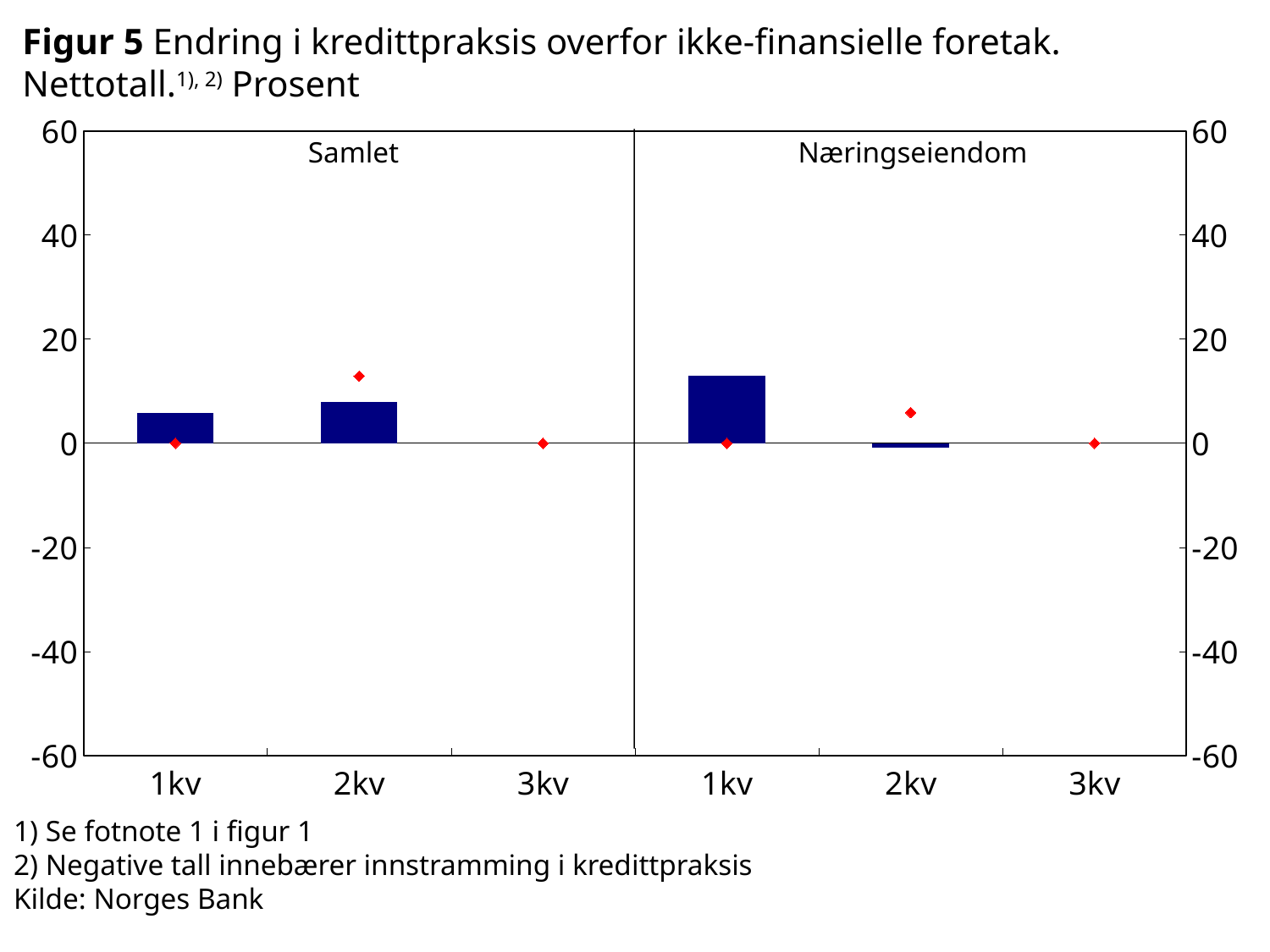
How many quarters are shown on the x axis of the Samlet panel? 3 Which is larger: the bar for 1kv in the Næringseiendom panel or the bar for 1kv in the Samlet panel? 1kv in the Næringseiendom panel Is the bar for 1kv in the Næringseiendom panel greater or less than 20? less Is the bar for 1kv in the Samlet panel greater or less than 0? greater What are the titles of the two panels in the chart? Samlet and Næringseiendom In the Næringseiendom panel, which quarter has the lowest bar? 2kv What is the source given for the chart? Norges Bank What kind of chart is shown in Figur 5? bar chart Is the bar for 2kv in the Næringseiendom panel greater or less than 0? less In the Næringseiendom panel, which quarter has the highest bar? 1kv What is the maximum value shown on the y axis? 60